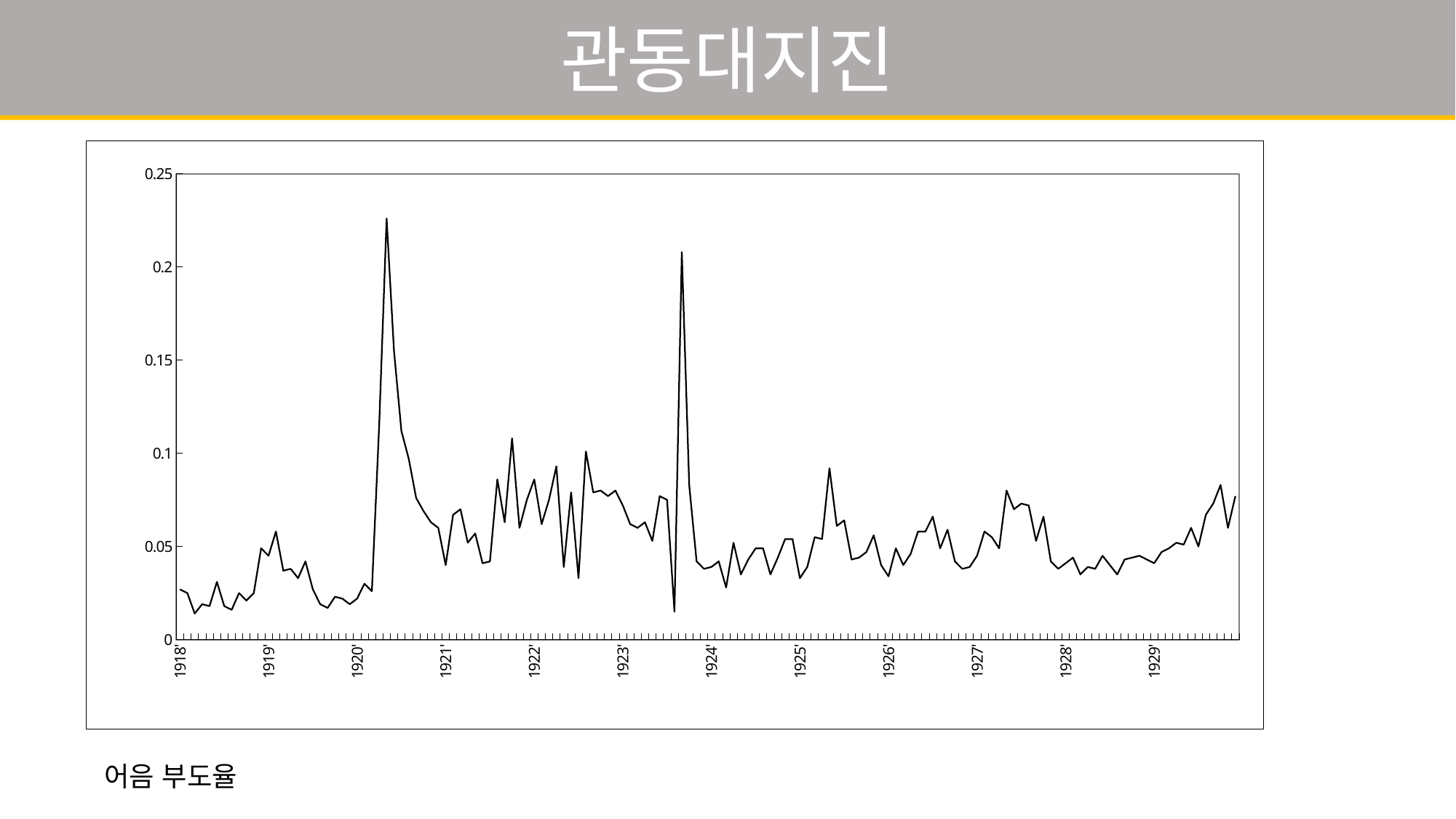
In which year does the line reach its highest peak? 1920 What is the highest value shown on the y axis of the chart? 0.25 What label appears below the chart describing the plotted series? 어음 부도율 What is the title of the slide containing the chart? 관동대지진 How many year labels are shown on the x axis of the chart? 12 Is the value at the start of 1918 greater or less than 0.05? less Is the peak value in 1920 greater or less than 0.2? greater What kind of chart is shown on the slide? line chart Is the sharp peak in 1923 greater or less than 0.15? greater How many lines are plotted on the chart? 1 Which is higher, the peak in 1920 or the peak in 1923? the peak in 1920